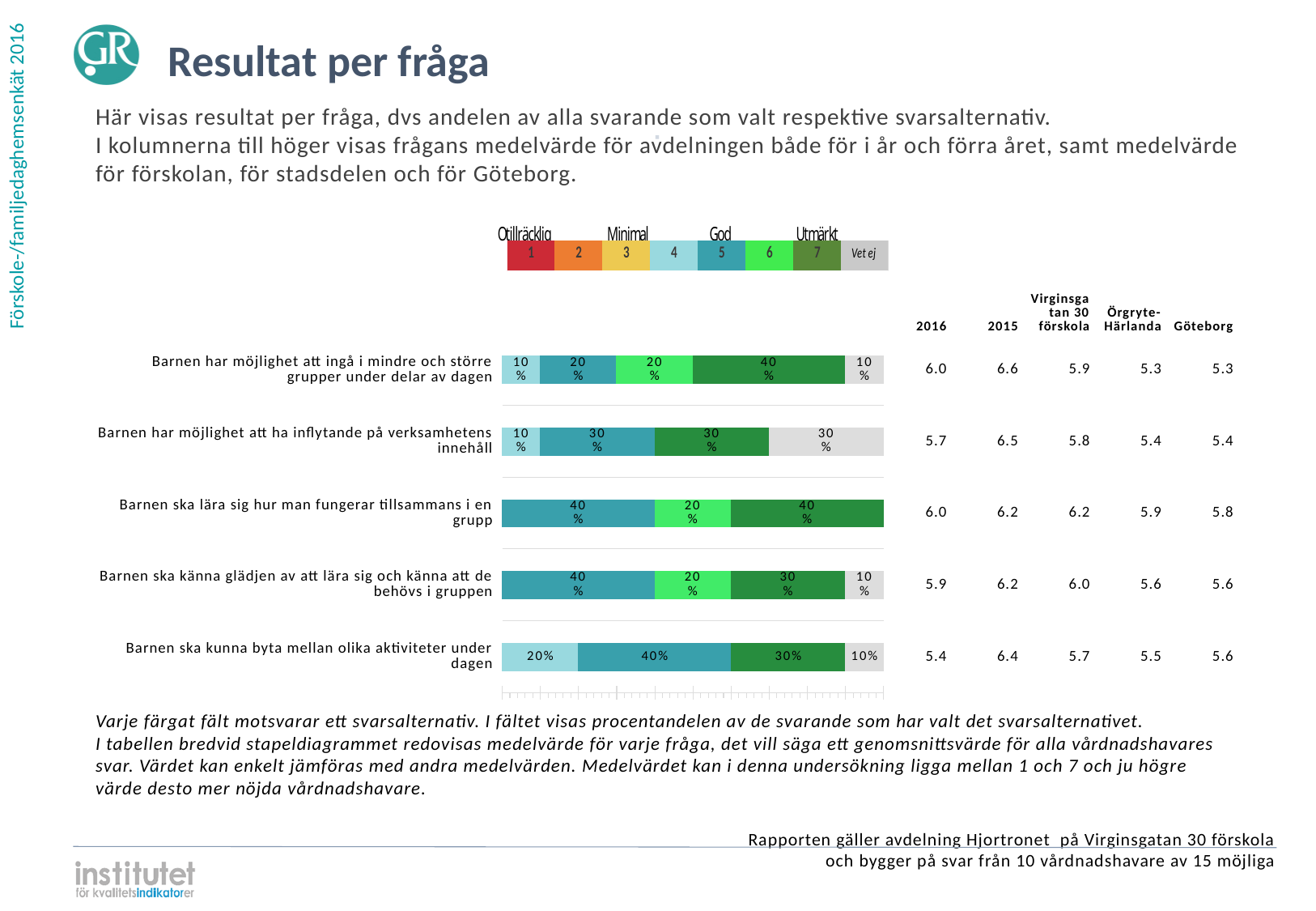
For 'Barnen ska känna glädjen av att lära sig och känna att de behövs i gruppen', what is the difference between the rating 5 share and the rating 7 share? 10% What share of respondents chose rating 5 (teal) for 'Barnen ska kunna byta mellan olika aktiviteter under dagen'? 40% How many entries does the colour legend above the chart list? 8 What do the segments of the bar for 'Barnen ska lära sig hur man fungerar tillsammans i en grupp' add up to? 100% What share of respondents answered 'Vet ej' for 'Barnen har möjlighet att ha inflytande på verksamhetens innehåll'? 30% What kind of chart is shown on the slide? Stacked bar chart What share of respondents chose rating 6 (bright green) for 'Barnen ska lära sig hur man fungerar tillsammans i en grupp'? 20% For 'Barnen ska kunna byta mellan olika aktiviteter under dagen', which is larger: the rating 4 share or the rating 7 share? Rating 7 share (30%) Which question has the largest 'Vet ej' share? Barnen har möjlighet att ha inflytande på verksamhetens innehåll How many questions (categories) are plotted in the bar chart? 5 Which rating label in the legend is shown in red? 1 (Otillräcklig) What share of respondents chose rating 7 (Utmärkt, dark green) for 'Barnen har möjlighet att ingå i mindre och större grupper under delar av dagen'? 40%